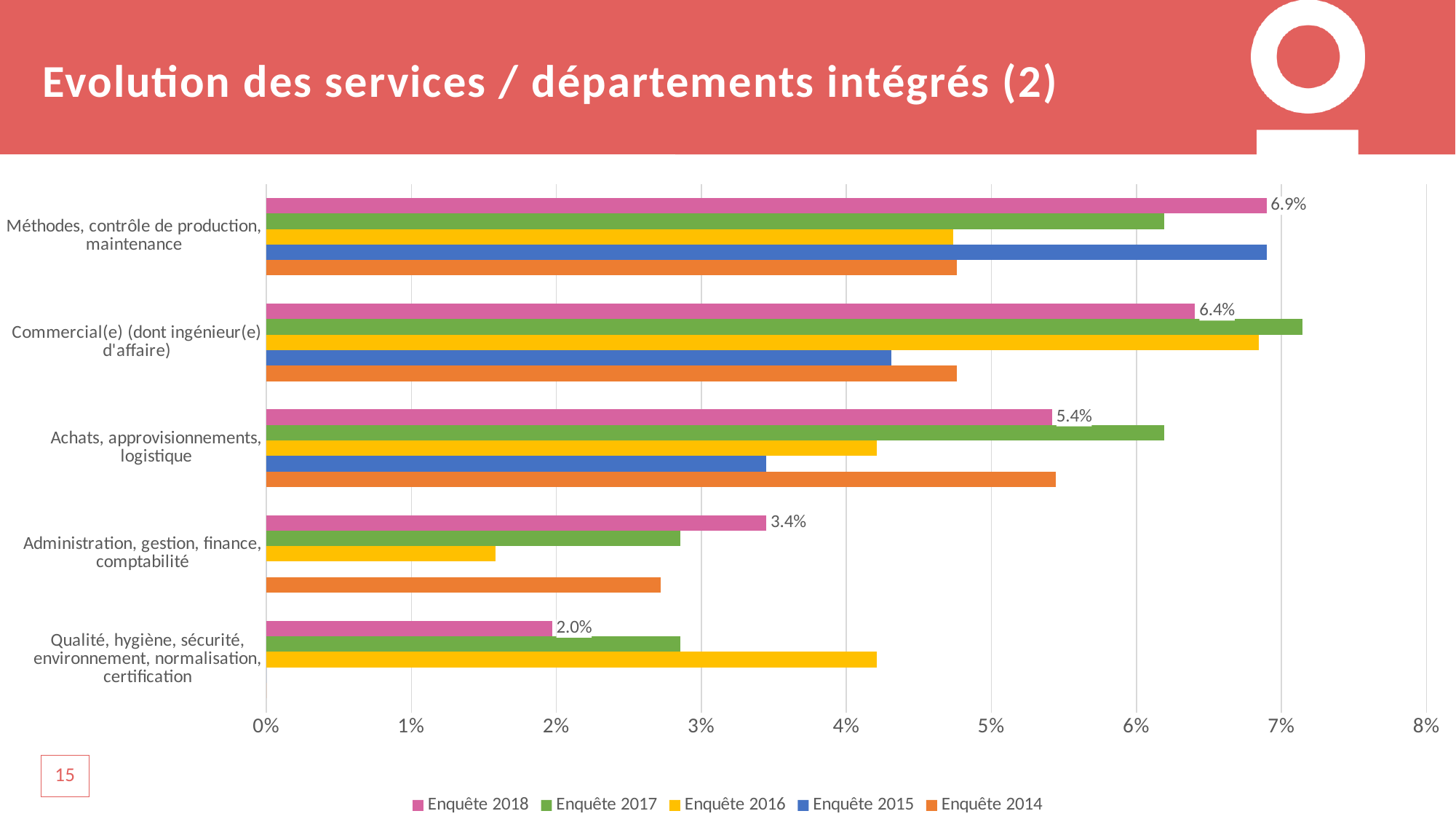
What is the Enquête 2018 value for Commercial(e) (dont ingénieur(e) d'affaire)? 6.4% Is the Enquête 2015 value for Achats, approvisionnements, logistique greater or less than 4%? less Which category has the lowest Enquête 2018 value? Qualité, hygiène, sécurité, environnement, normalisation, certification How many series does the legend list? 5 Is the Enquête 2015 value for Méthodes, contrôle de production, maintenance greater or less than 6%? greater For Enquête 2018, which is larger: Achats, approvisionnements, logistique or Administration, gestion, finance, comptabilité? Achats, approvisionnements, logistique Which category has the highest Enquête 2018 value? Méthodes, contrôle de production, maintenance What is the difference between the Enquête 2018 values for Méthodes, contrôle de production, maintenance and Qualité, hygiène, sécurité, environnement, normalisation, certification? 4.9% What is the Enquête 2018 value for Méthodes, contrôle de production, maintenance? 6.9% How many categories are shown on the chart? 5 What type of chart is shown on the slide? Bar chart What is the Enquête 2018 value for Qualité, hygiène, sécurité, environnement, normalisation, certification? 2.0%